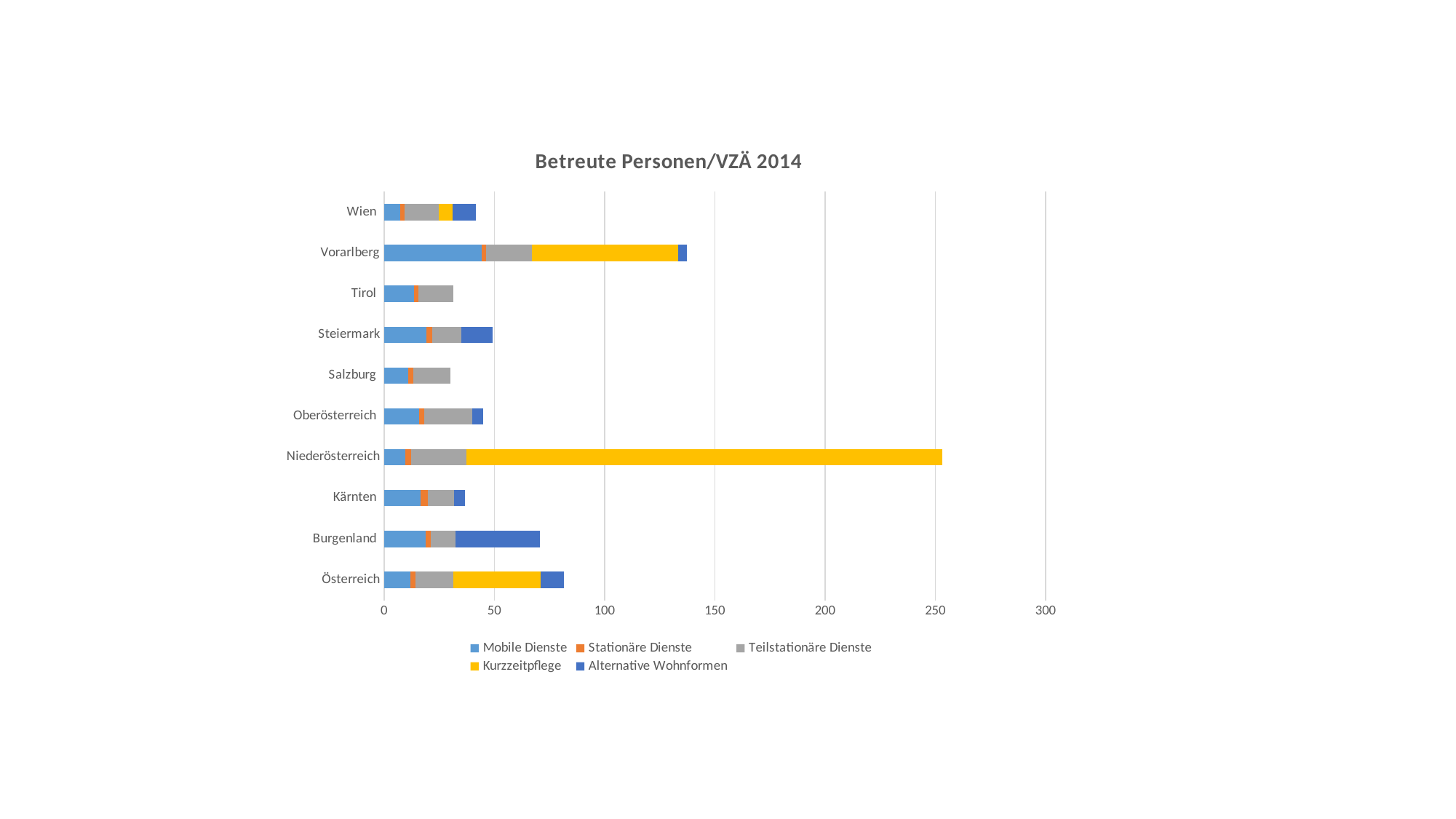
What is the title of the chart? Betreute Personen/VZÄ 2014 Is the total value for Tirol greater or less than 50? less Which region has the largest Alternative Wohnformen segment? Burgenland What kind of chart is shown on the slide? bar chart Which has the larger total bar, Vorarlberg or Burgenland? Vorarlberg Is the total value for Burgenland greater or less than 50? greater How many categories (regions) are shown on the chart? 10 Which series is shown in yellow in the legend? Kurzzeitpflege Is the total value for Vorarlberg greater or less than 100? greater How many series does the legend list? 5 Which region has the longest total bar? Niederösterreich